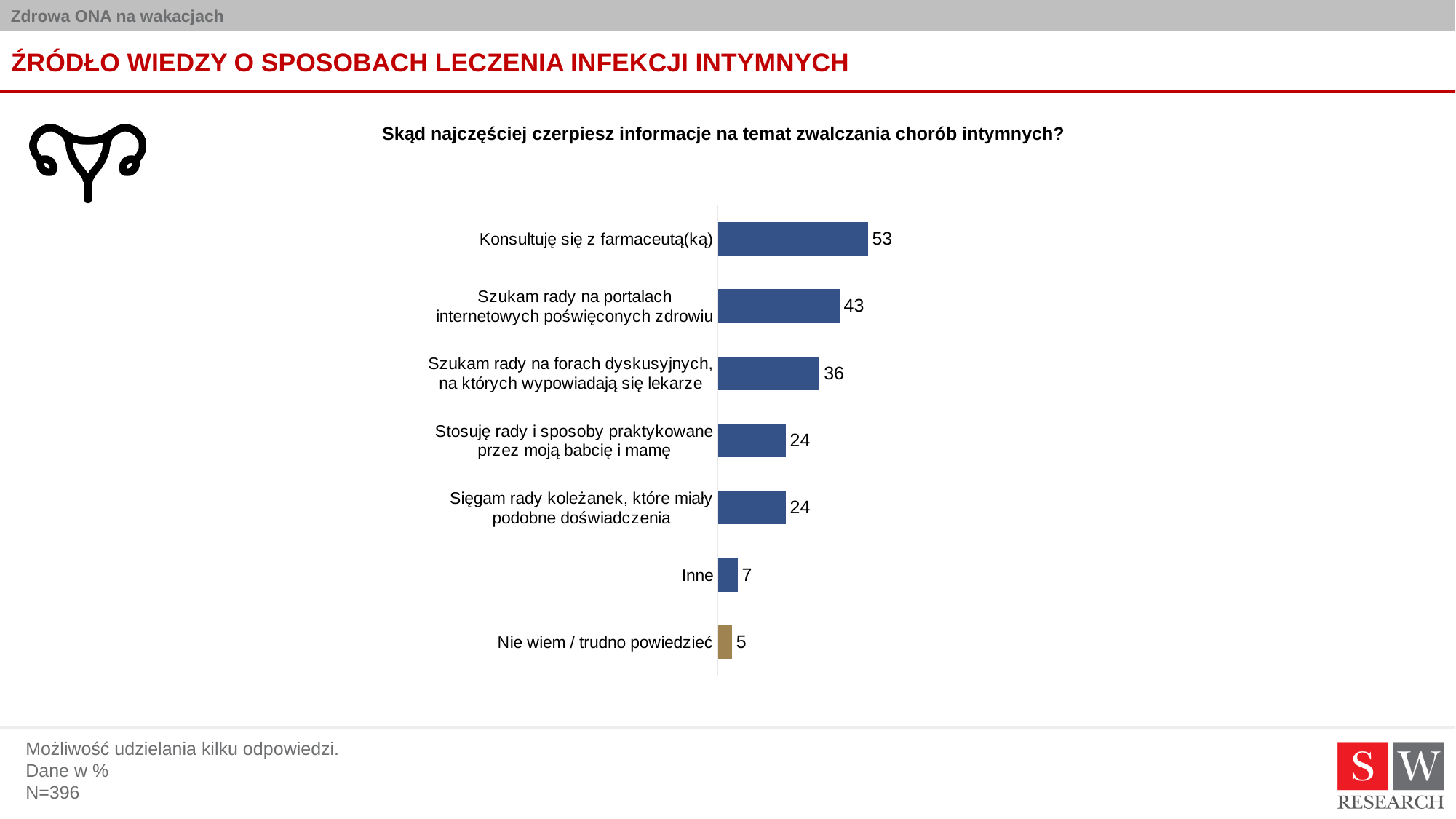
What is the difference between the values for "Szukam rady na forach dyskusyjnych, na których wypowiadają się lekarze" and "Inne"? 29 Which category has the lowest value? Nie wiem / trudno powiedzieć What is the value for "Szukam rady na portalach internetowych poświęconych zdrowiu"? 43 What kind of chart is shown on the slide? Bar chart What question is shown as the chart's title? Skąd najczęściej czerpiesz informacje na temat zwalczania chorób intymnych? Which category has the highest value? Konsultuję się z farmaceutą(ką) What is the value for "Inne"? 7 What is the value for "Nie wiem / trudno powiedzieć"? 5 Which is larger: the value for "Szukam rady na forach dyskusyjnych, na których wypowiadają się lekarze" or for "Stosuję rady i sposoby praktykowane przez moją babcię i mamę"? Szukam rady na forach dyskusyjnych, na których wypowiadają się lekarze What is the value for "Konsultuję się z farmaceutą(ką)"? 53 What is the difference between the values for "Konsultuję się z farmaceutą(ką)" and "Szukam rady na portalach internetowych poświęconych zdrowiu"? 10 How many categories are shown in the chart? 7